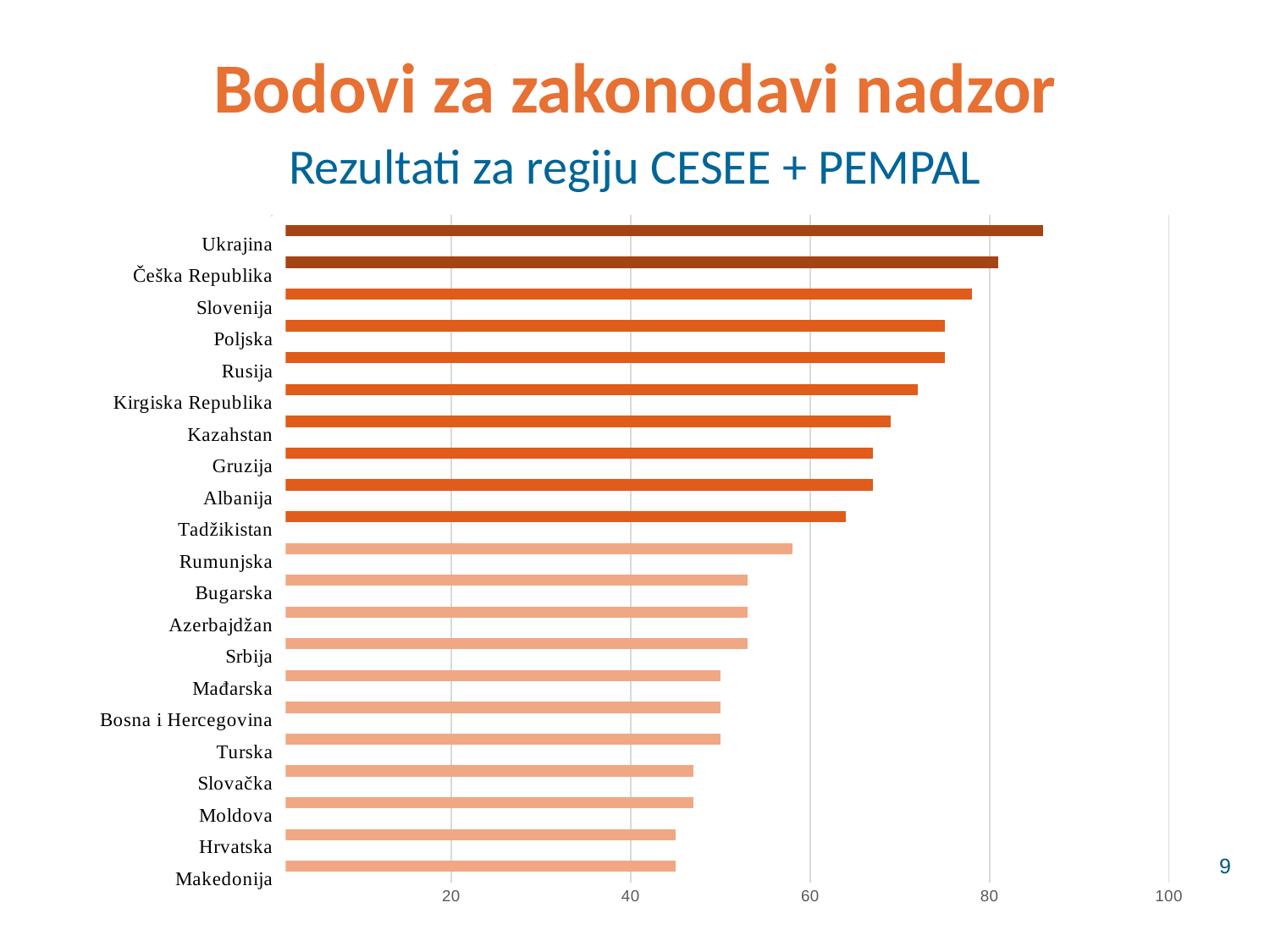
Is the value for Kazahstan greater or less than 60? greater Which has a higher value, Turska or Kazahstan? Kazahstan Is the value for Bugarska greater or less than 60? less Do the bar values increase or decrease going from the top of the chart to the bottom? decrease Which has a higher value, Slovenija or Rumunjska? Slovenija Is the value for Slovačka greater or less than 40? greater How many countries are plotted in the chart? 21 What is the subtitle shown above the chart? Rezultati za regiju CESEE + PEMPAL Which country has the highest score in the chart? Ukrajina What kind of chart is shown on the slide? bar chart